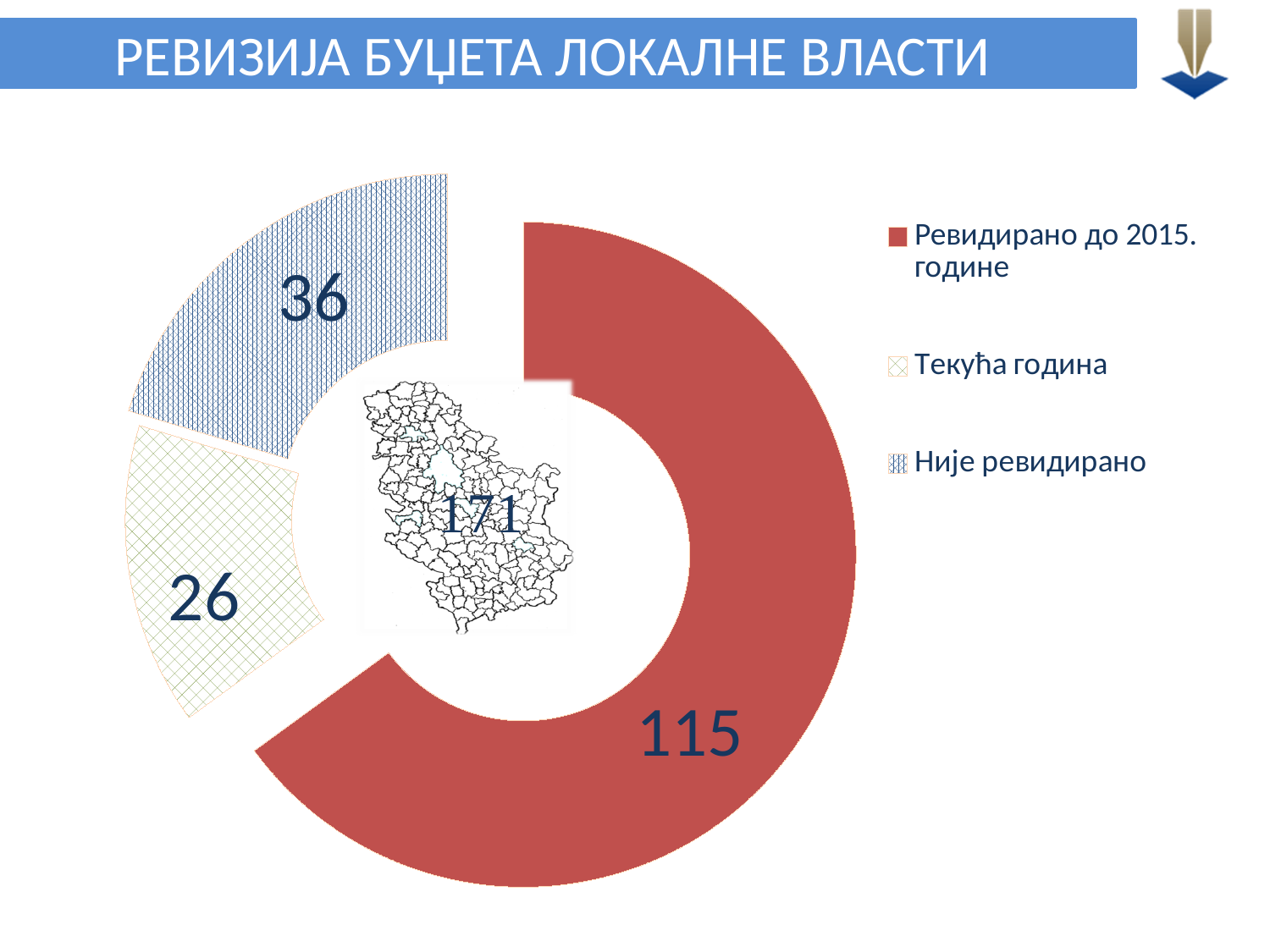
What is the value for "Текућа година"? 26 How many categories does the chart show? 3 What is the value for "Ревидирано до 2015. године"? 115 What is the title of the slide containing the chart? РЕВИЗИЈА БУЏЕТА ЛОКАЛНЕ ВЛАСТИ Which is larger, the value for "Није ревидирано" or the value for "Текућа година"? Није ревидирано What is the value for "Није ревидирано"? 36 What is the difference between the values for "Није ревидирано" and "Текућа година"? 10 What total is shown in the centre of the chart? 171 Which category has the largest value? Ревидирано до 2015. године What kind of chart is shown on the slide? doughnut chart What is the difference between the values for "Ревидирано до 2015. године" and "Није ревидирано"? 79 Which category has the smallest value? Текућа година